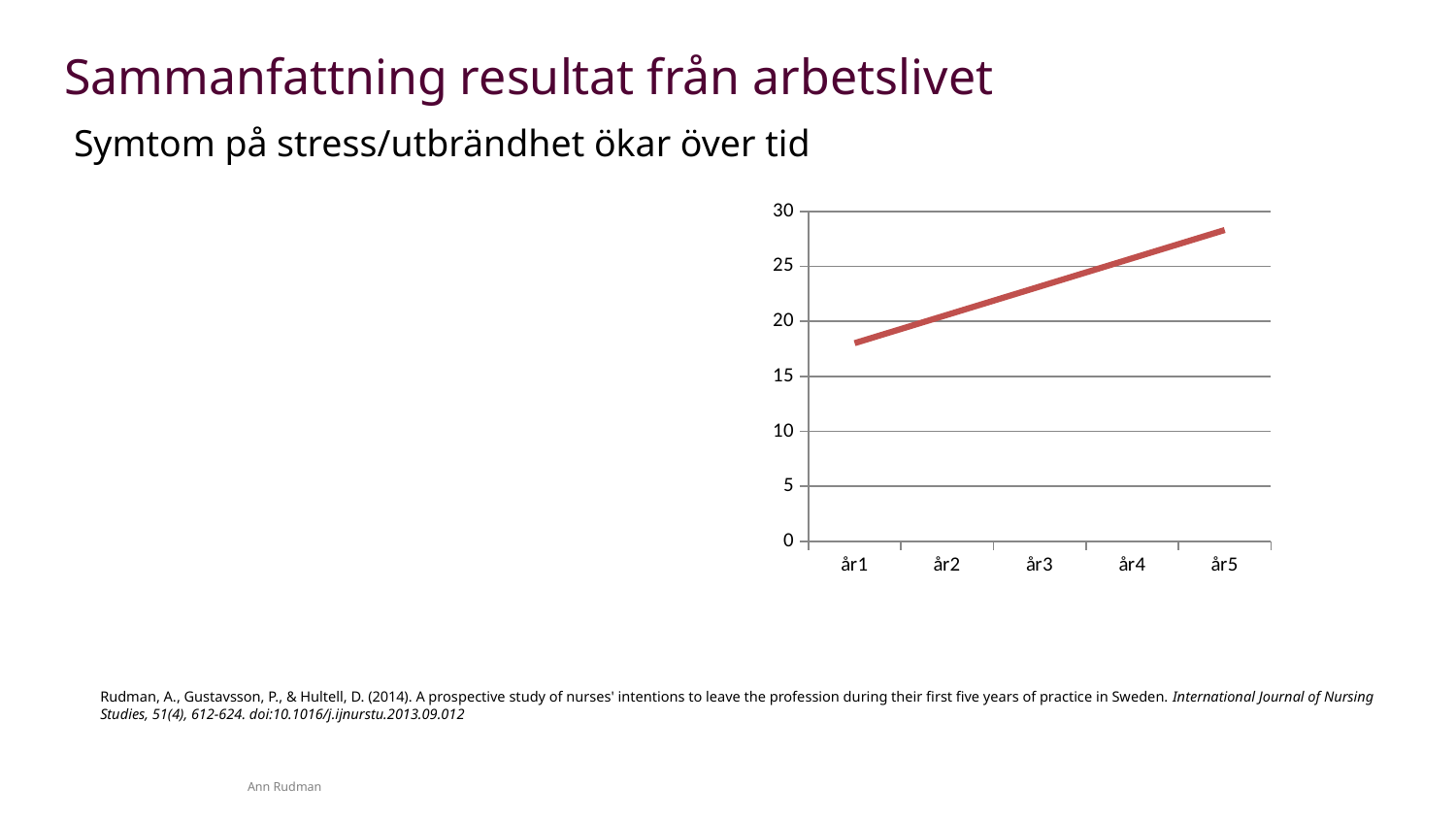
Which is larger, the value for år5 or the value for år1? år5 What is the highest tick value shown on the y axis? 30 Which year has the highest value? år5 Do the values rise or fall from år1 to år5? rise How many points (years) are plotted along the x axis? 5 Is the value for år1 greater or less than 20? less Is the value for år5 greater or less than 25? greater Is the value for år3 greater or less than 20? greater Which year has the lowest value? år1 What kind of chart is shown on the slide? line chart What is the label of the first category on the x axis? år1